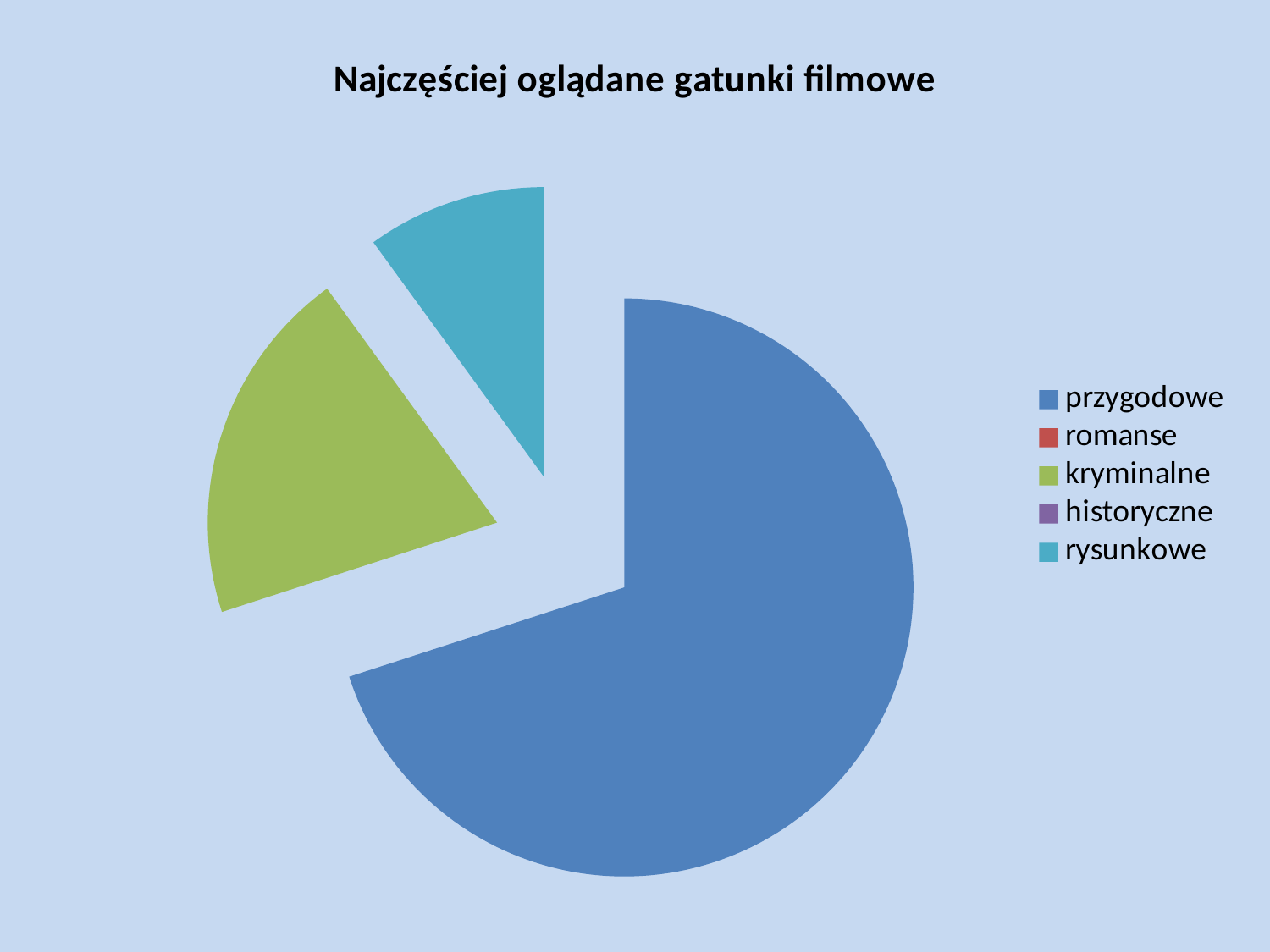
Is the share of przygodowe greater or less than half of the pie? greater How many slices are visibly drawn in the pie? 3 Which legend entries have no visible slice in the pie? romanse and historyczne Which slice is larger, kryminalne or rysunkowe? kryminalne What kind of chart is shown on the slide? pie chart What is the title of the chart? Najczęściej oglądane gatunki filmowe Which category has the largest slice of the pie? przygodowe How many categories does the legend list? 5 Which colour represents przygodowe in the chart? blue Which slice is larger, przygodowe or kryminalne? przygodowe